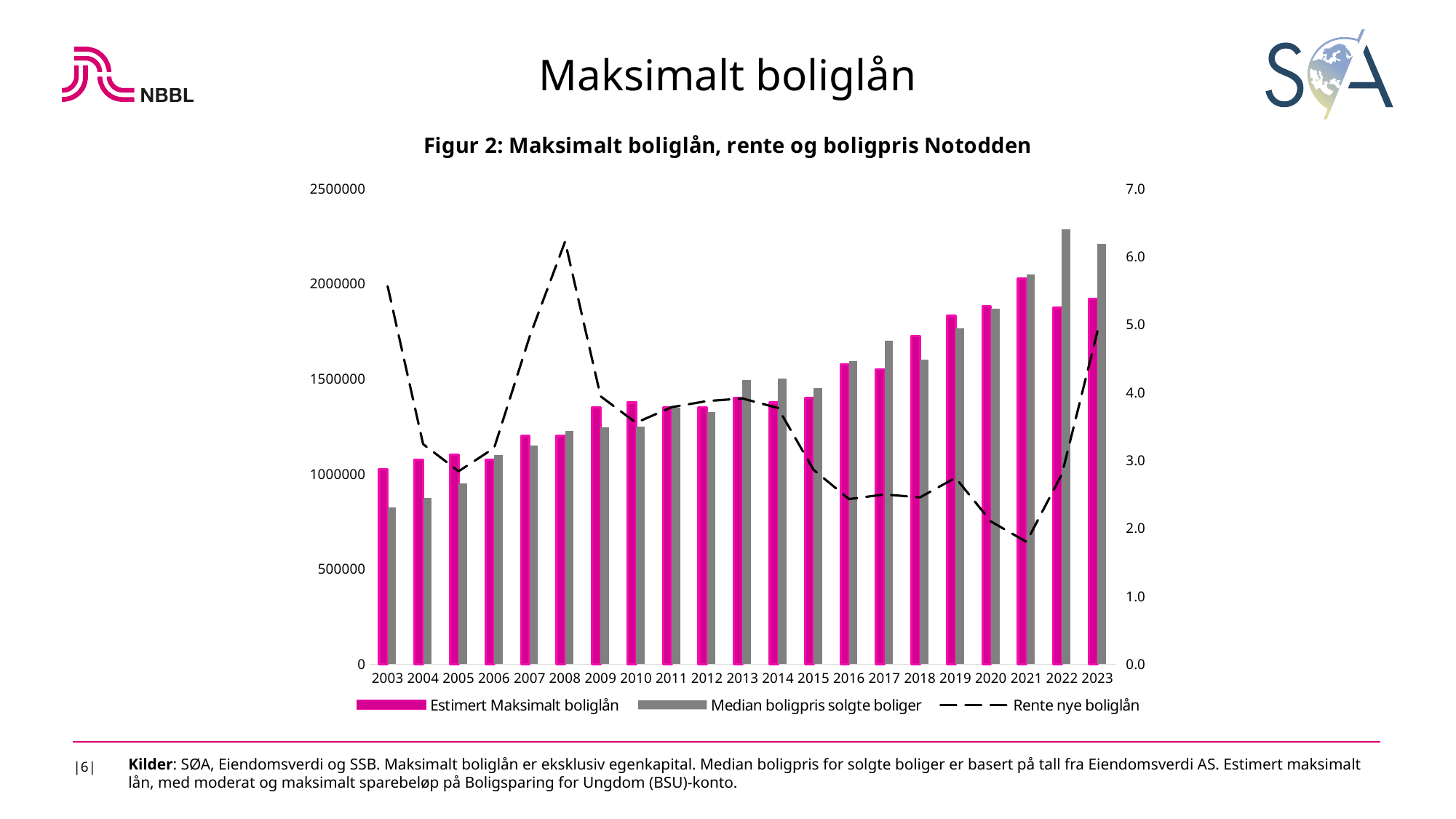
How many years are shown on the x axis of Figur 2? 21 Is the value for Rente nye boliglån in 2021 greater or less than 2.0? less Is the value for Median boligpris solgte boliger in 2003 greater or less than 1000000? less In which year is the Median boligpris solgte boliger bar lowest? 2003 How many series does the legend of Figur 2 list? 3 Does the Median boligpris solgte boliger series generally rise or fall from 2003 to 2023? Rise In 2022, which is larger: Estimert Maksimalt boliglån or Median boligpris solgte boliger? Median boligpris solgte boliger In which year is the Median boligpris solgte boliger bar highest? 2022 In which year is the Estimert Maksimalt boliglån bar highest? 2021 In which year does the Rente nye boliglån line reach its highest point? 2008 What kind of chart is shown in Figur 2? A combined bar and line chart Is the value for Estimert Maksimalt boliglån in 2021 greater or less than 2000000? greater